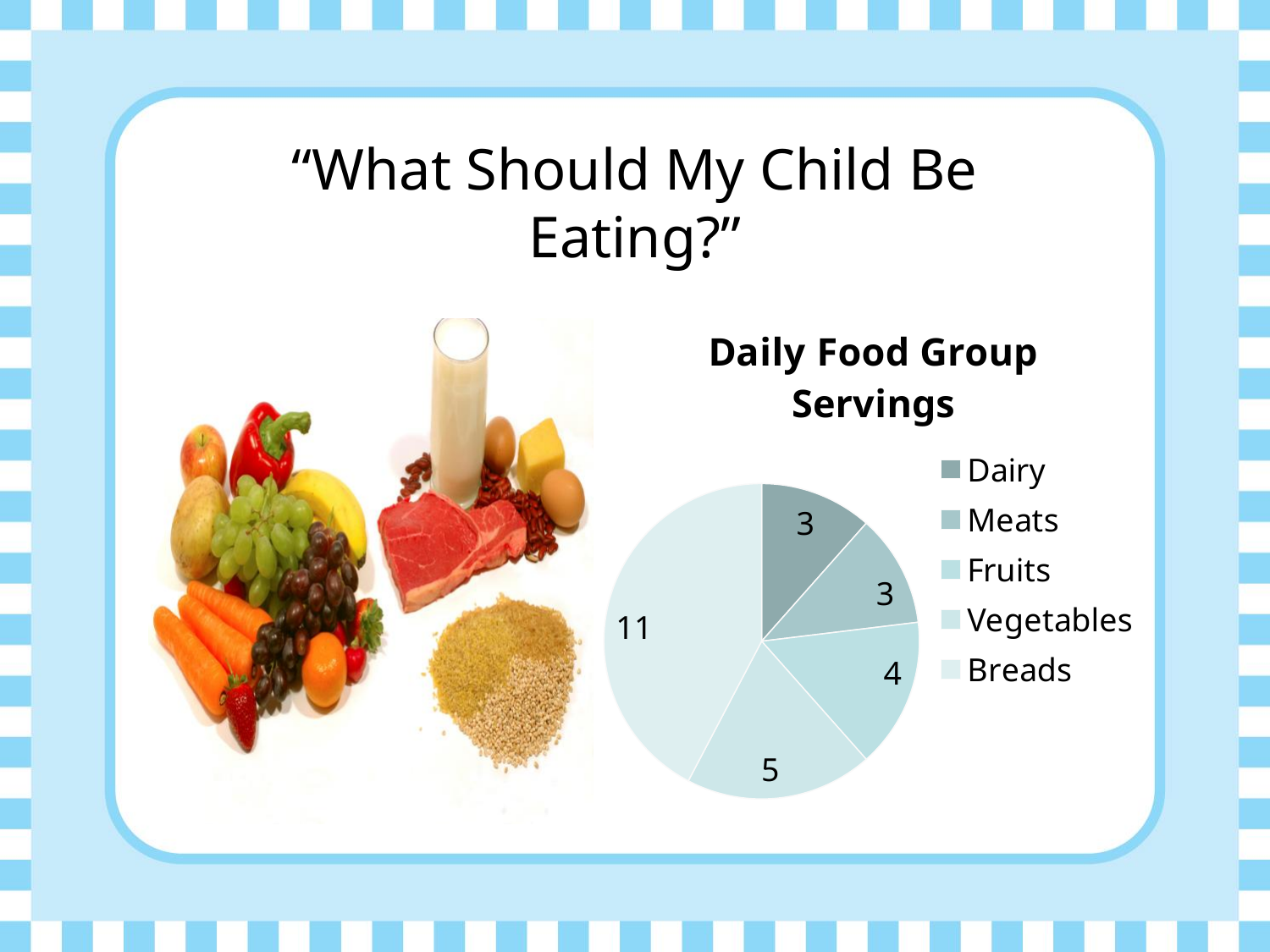
What is the title of the chart? Daily Food Group Servings How many daily servings of Dairy does the chart show? 3 How many daily servings of Breads does the chart show? 11 How many entries does the legend list? 5 What is the difference between the servings for Breads and the servings for Vegetables? 6 How many daily servings of Fruits does the chart show? 4 What is the total number of daily servings across all food groups in the chart? 26 Which food group has the largest slice of the pie? Breads Which has more daily servings, Fruits or Vegetables? Vegetables How many food groups are shown in the pie chart? 5 What type of chart is shown on the slide? Pie chart How many daily servings of Vegetables does the chart show? 5